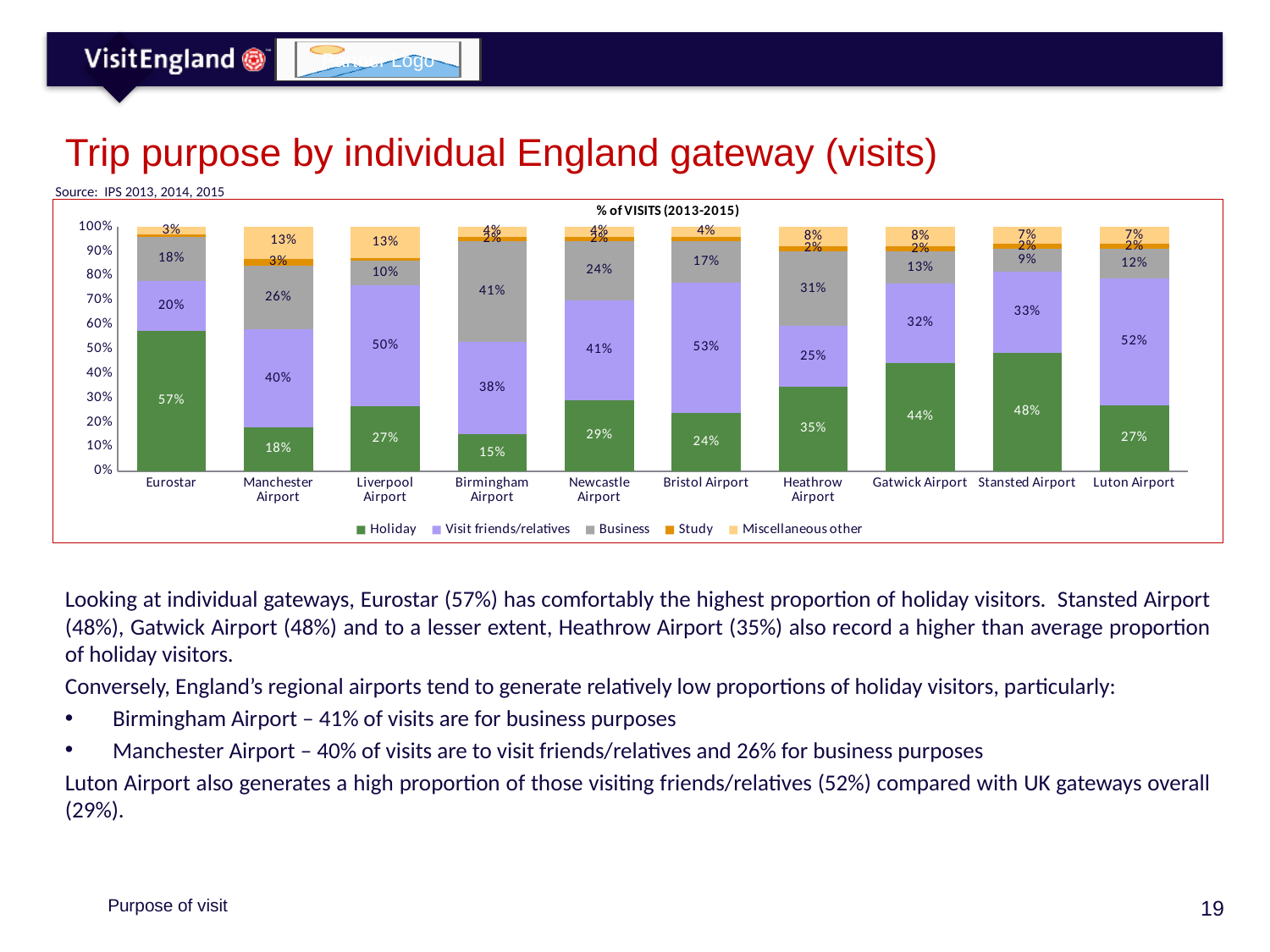
Which is larger: the Business share for Heathrow Airport or the Business share for Newcastle Airport? Heathrow Airport Which gateway has the highest Holiday share of visits? Eurostar What is the Holiday share of visits for Eurostar? 57% What is the Miscellaneous other share of visits for Manchester Airport? 13% How many series does the chart legend list? 5 What is the difference between the Holiday share for Stansted Airport and the Holiday share for Gatwick Airport? 4% How many gateways are shown along the x axis of the chart? 10 Which gateway has the lowest Holiday share of visits? Birmingham Airport What is the Visit friends/relatives share of visits for Luton Airport? 52% What is the Business share of visits for Birmingham Airport? 41% What kind of chart is shown on the slide? Stacked bar chart What is the title of the chart? % of VISITS (2013-2015)